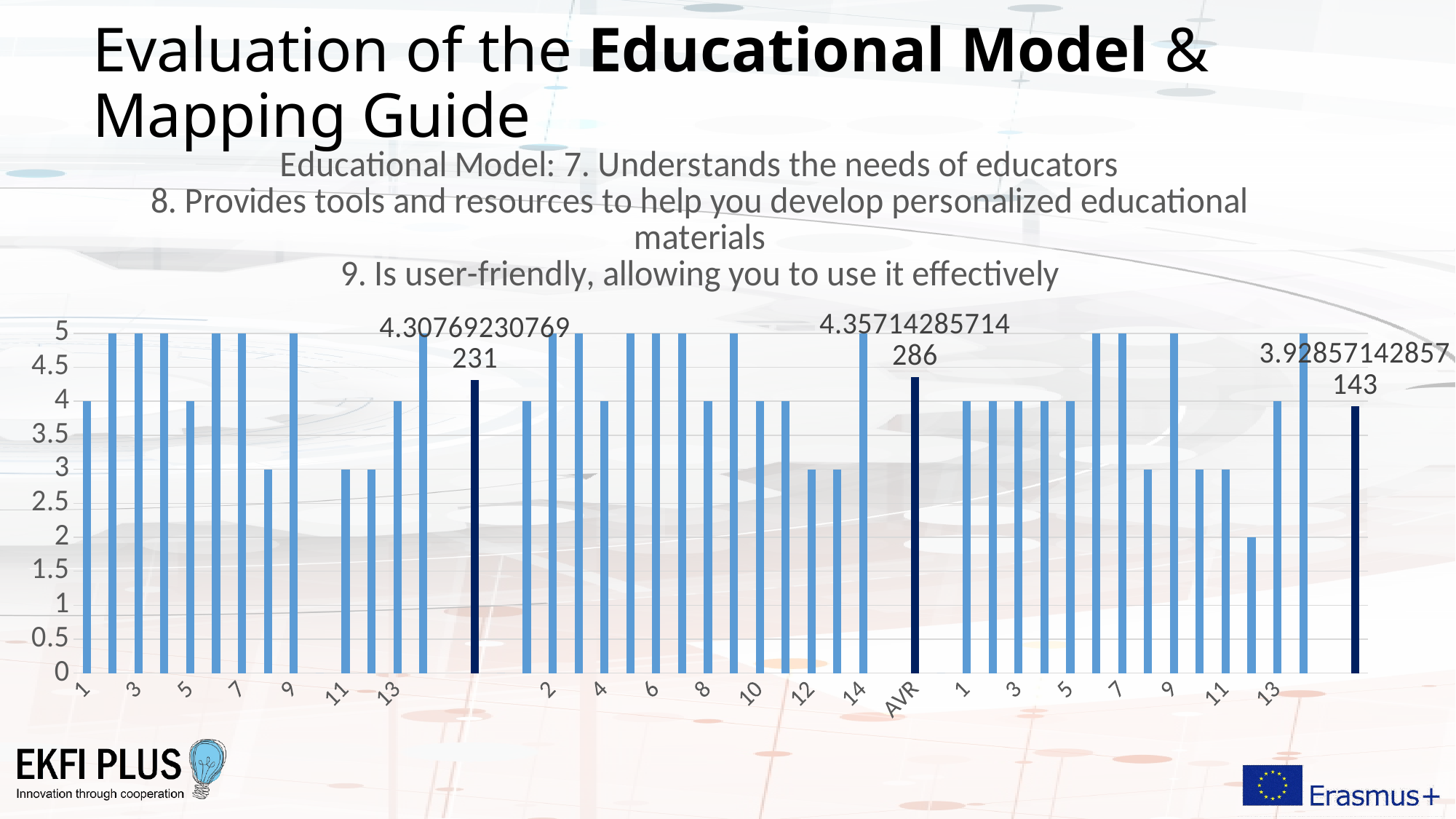
What is the value of the AVR bar for the third group (item 9, Is user-friendly)? 3.92857142857143 Which of the three AVR bars is the lowest? the third group (item 9), 3.92857142857143 Which is larger, the AVR for the first group (item 7) or the AVR for the third group (item 9)? the first group (item 7) How many AVR (average) bars are shown in the chart? 3 What is the value of the AVR bar for the second group (item 8, Provides tools and resources)? 4.35714285714286 What is the difference between the AVR of the second group (4.35714285714286) and the AVR of the first group (4.30769230769231)? 0.04945054945055 Which of the three AVR bars is the highest? the second group (item 8), 4.35714285714286 What is the lowest individual rating given in the third group (item 9), at respondent 12? 2 Is the AVR value for the first group (item 7) greater or less than 4? greater Is the AVR value for the third group (item 9) greater or less than 4? less What kind of chart is shown on the slide? bar chart What is the value of the AVR bar for the first group (item 7, Understands the needs of educators)? 4.30769230769231